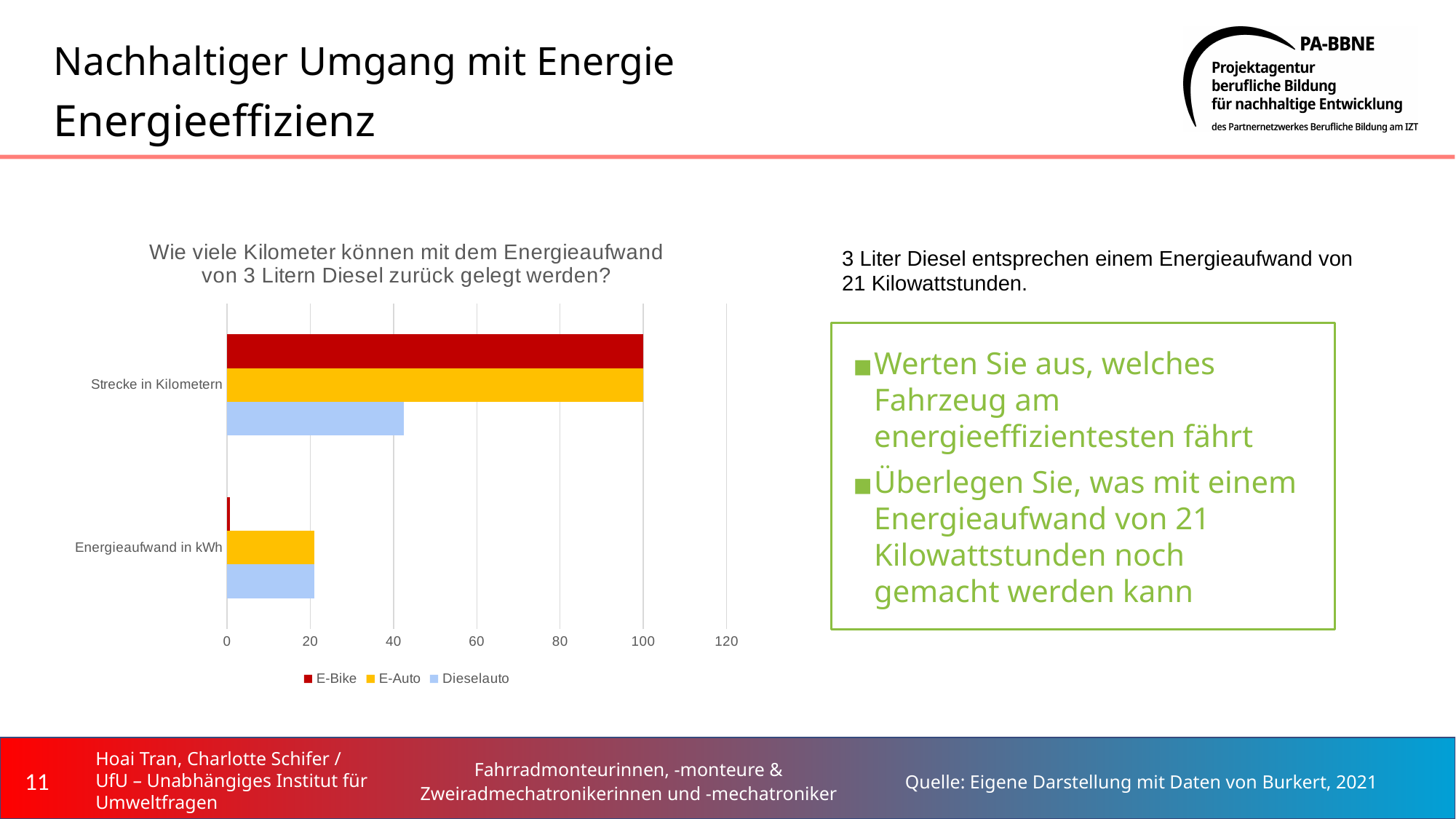
Which series has the lowest value in the category Strecke in Kilometern? Dieselauto What is the value for E-Auto in the category Strecke in Kilometern? 100 What is the value for E-Bike in the category Strecke in Kilometern? 100 In the category Strecke in Kilometern, which is larger: E-Bike or Dieselauto? E-Bike Which series has the lowest value in the category Energieaufwand in kWh? E-Bike How many series does the chart legend list? 3 What kind of chart is shown on the slide? bar chart Which colour represents E-Bike in the chart legend? red How many categories are shown on the vertical axis of the chart? 2 Is the value for E-Bike in Energieaufwand in kWh greater or less than 20? less In the category Energieaufwand in kWh, which is larger: E-Bike or E-Auto? E-Auto Is the value for Dieselauto in Strecke in Kilometern greater or less than 60? less